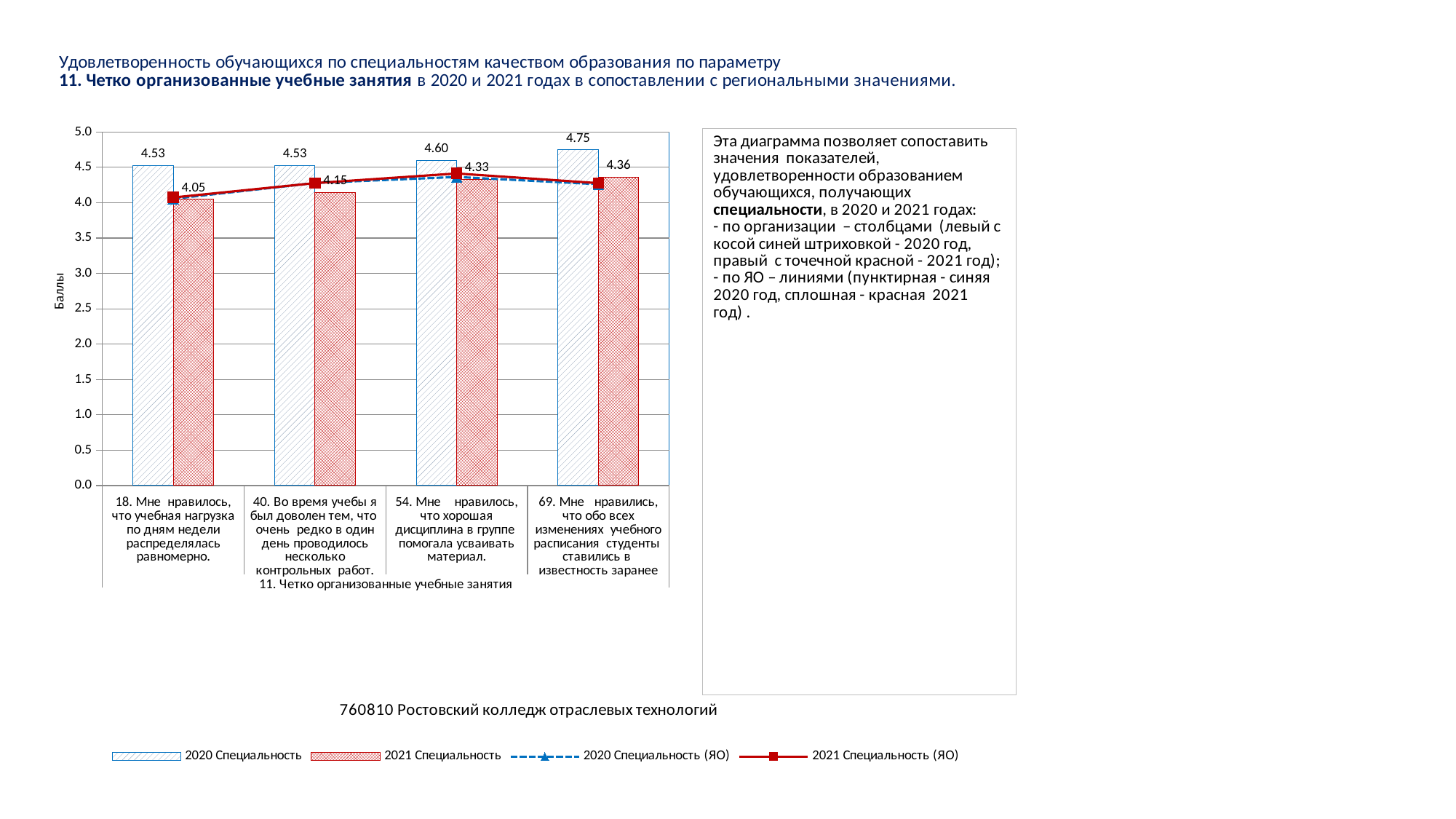
Do the 2021 Специальность bar values rise or fall from item 18 to item 69? rise Is the 2021 Специальность (ЯО) line value for item 18 greater or less than 4.5? less What is the difference between the 2020 Специальность values for item 69 and item 54? 0.15 Which is larger for item 40: the 2020 Специальность value or the 2021 Специальность value? 2020 Специальность What is the 2020 Специальность value for item 18 (Мне нравилось, что учебная нагрузка по дням недели распределялась равномерно)? 4.53 What is the difference between the 2020 and 2021 Специальность values for item 18? 0.48 What is the 2021 Специальность value for item 69 (Мне нравились, что обо всех изменениях учебного расписания студенты ставились в известность заранее)? 4.36 Which item has the highest 2020 Специальность value? 69. Мне нравились, что обо всех изменениях учебного расписания студенты ставились в известность заранее Which item has the lowest 2021 Специальность value? 18. Мне нравилось, что учебная нагрузка по дням недели распределялась равномерно. How many series does the legend list? 4 How many categories (items) are shown on the x axis? 4 What is the 2021 Специальность value for item 54 (Мне нравилось, что хорошая дисциплина в группе помогала усваивать материал)? 4.33